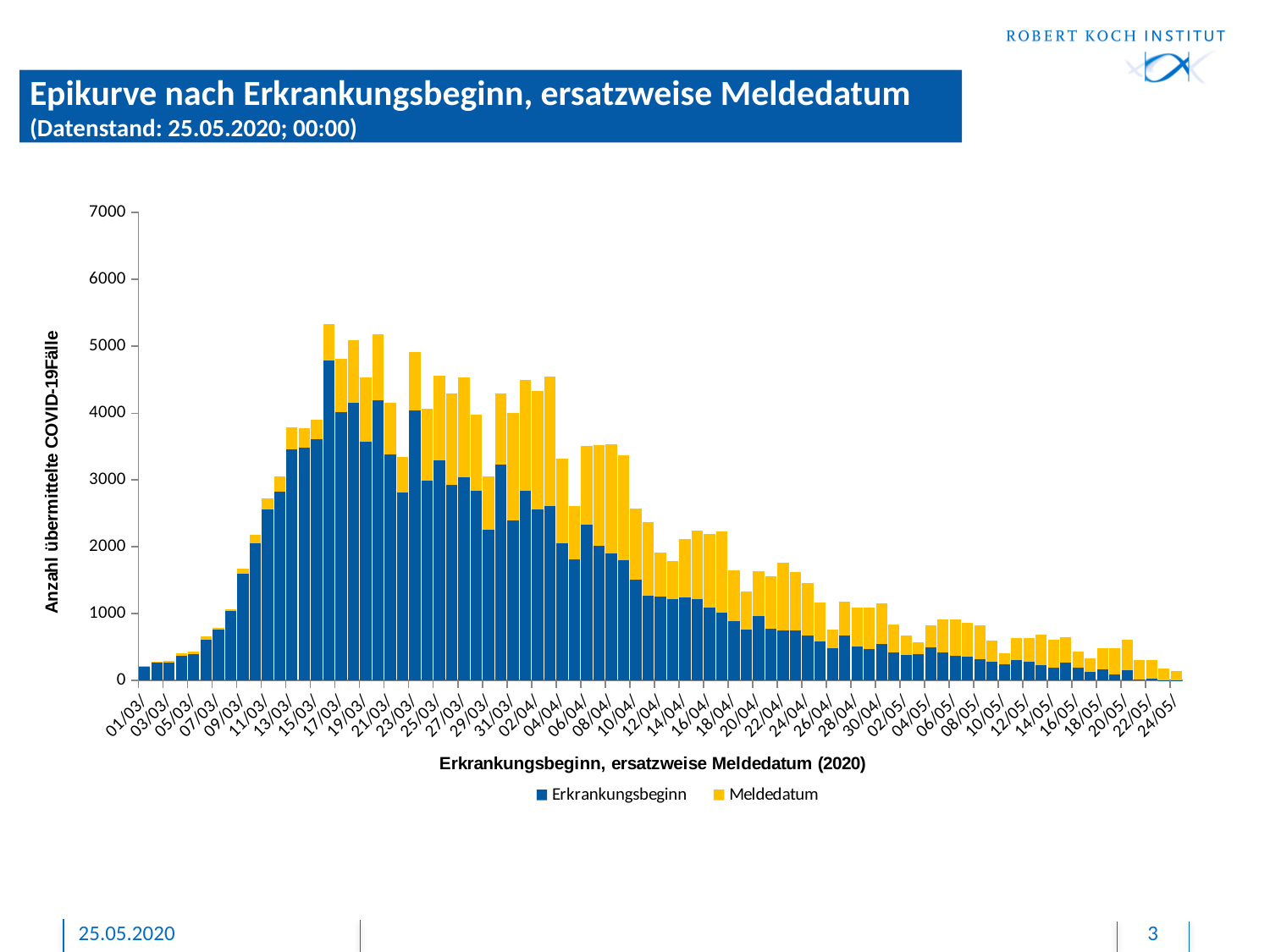
What is the highest tick value shown on the y axis? 7000 How many series does the legend list? 2 Is the total value of the bar for 24/05 greater or less than 500? less Which bar has the larger total, 17/03 or 24/05? 17/03 Which two series are listed in the chart legend? Erkrankungsbeginn and Meldedatum Which colour represents the Meldedatum series? Yellow Do the bar totals generally rise or fall from 17/03 to 24/05? Fall Is the total value of the bar for 01/03 greater or less than 1000? less What kind of chart is shown on the slide? Stacked bar chart On which date does the Erkrankungsbeginn (blue) series reach its highest value? 16/03